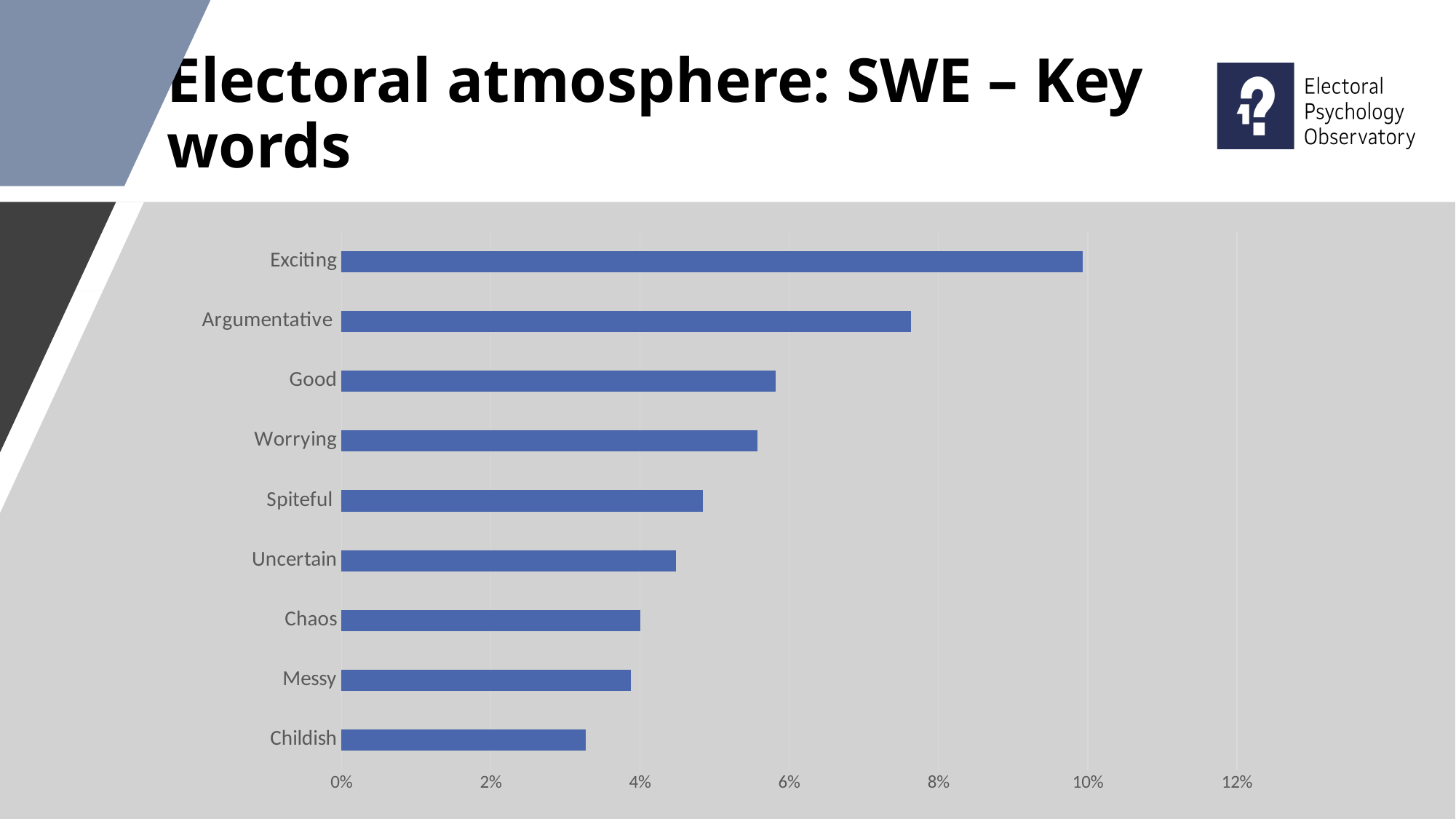
Which has a larger value, Exciting or Argumentative? Exciting Which key word has the highest value in the chart? Exciting What kind of chart is shown on the slide? bar chart Which key word has the lowest value in the chart? Childish Is the value for Childish greater or less than 4%? less How many key words (categories) are plotted in the chart? 9 Is the value for Uncertain greater or less than 6%? less What is the title of the slide containing the chart? Electoral atmosphere: SWE – Key words Which has a larger value, Spiteful or Childish? Spiteful Is the value for Argumentative greater or less than 8%? less